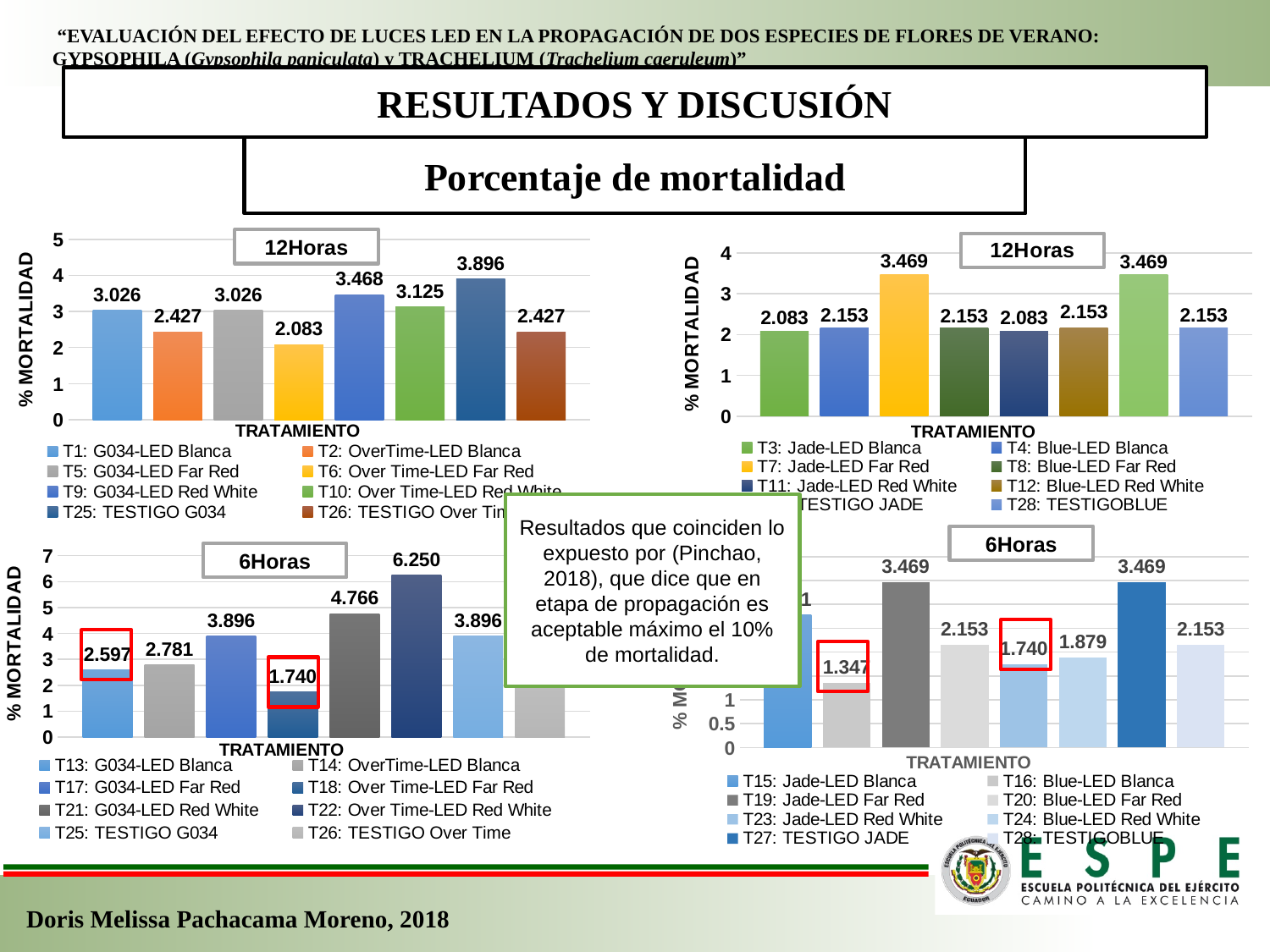
In the top-right 12Horas chart, what is the value for T7: Jade-LED Far Red? 3.469 In the bottom-right 6Horas chart, which is larger, the value for T19: Jade-LED Far Red or T20: Blue-LED Far Red? T19: Jade-LED Far Red In the top-left 12Horas chart, which treatment has the lowest % mortalidad? T6: Over Time-LED Far Red What type of chart is the top-left 12Horas chart? Bar chart In the top-right 12Horas chart, what is the difference between the values for T7: Jade-LED Far Red and T3: Jade-LED Blanca? 1.386 In the bottom-left 6Horas chart, what is the difference between the values for T22: Over Time-LED Red White and T21: G034-LED Red White? 1.484 In the top-left 12Horas chart, what is the % mortalidad value for T25: TESTIGO G034? 3.896 In the bottom-right 6Horas chart, which treatment has the lowest % mortalidad? T16: Blue-LED Blanca In the bottom-left 6Horas chart, which treatment has the highest % mortalidad? T22: Over Time-LED Red White In the top-left 12Horas chart, which treatment has the highest % mortalidad? T25: TESTIGO G034 In the bottom-left 6Horas chart, what is the value for T18: Over Time-LED Far Red? 1.740 In the top-right 12Horas chart, how many bars are plotted? 8